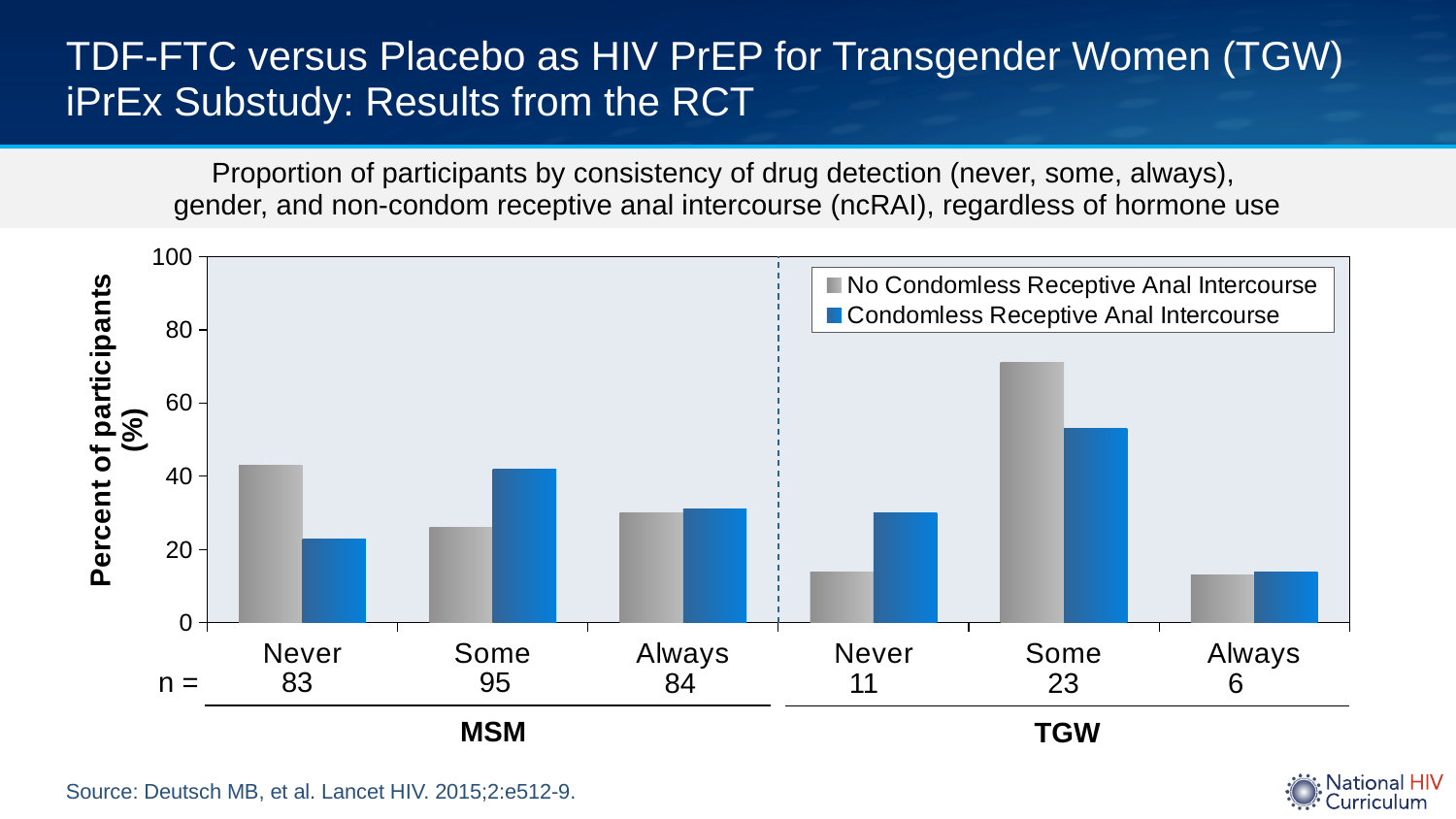
In the MSM 'Never' group, which series has the larger value: No Condomless Receptive Anal Intercourse or Condomless Receptive Anal Intercourse? No Condomless Receptive Anal Intercourse What is the n value shown for the TGW 'Always' group? 6 How many category groups (drug detection levels across both genders) are shown on the x axis? 6 Is the value for Condomless Receptive Anal Intercourse in the MSM 'Never' group greater or less than 40? less What kind of chart is shown on the slide? bar chart In the TGW 'Never' group, which series has the larger value: No Condomless Receptive Anal Intercourse or Condomless Receptive Anal Intercourse? Condomless Receptive Anal Intercourse How many series does the legend list? 2 What colour represents the Condomless Receptive Anal Intercourse series? blue What is the n value shown for the MSM 'Some' group? 95 Is the value for No Condomless Receptive Anal Intercourse in the TGW 'Some' group greater or less than 60? greater Which category has the tallest bar in the chart? Some (TGW), No Condomless Receptive Anal Intercourse Is the value for Condomless Receptive Anal Intercourse in the TGW 'Some' group greater or less than 40? greater